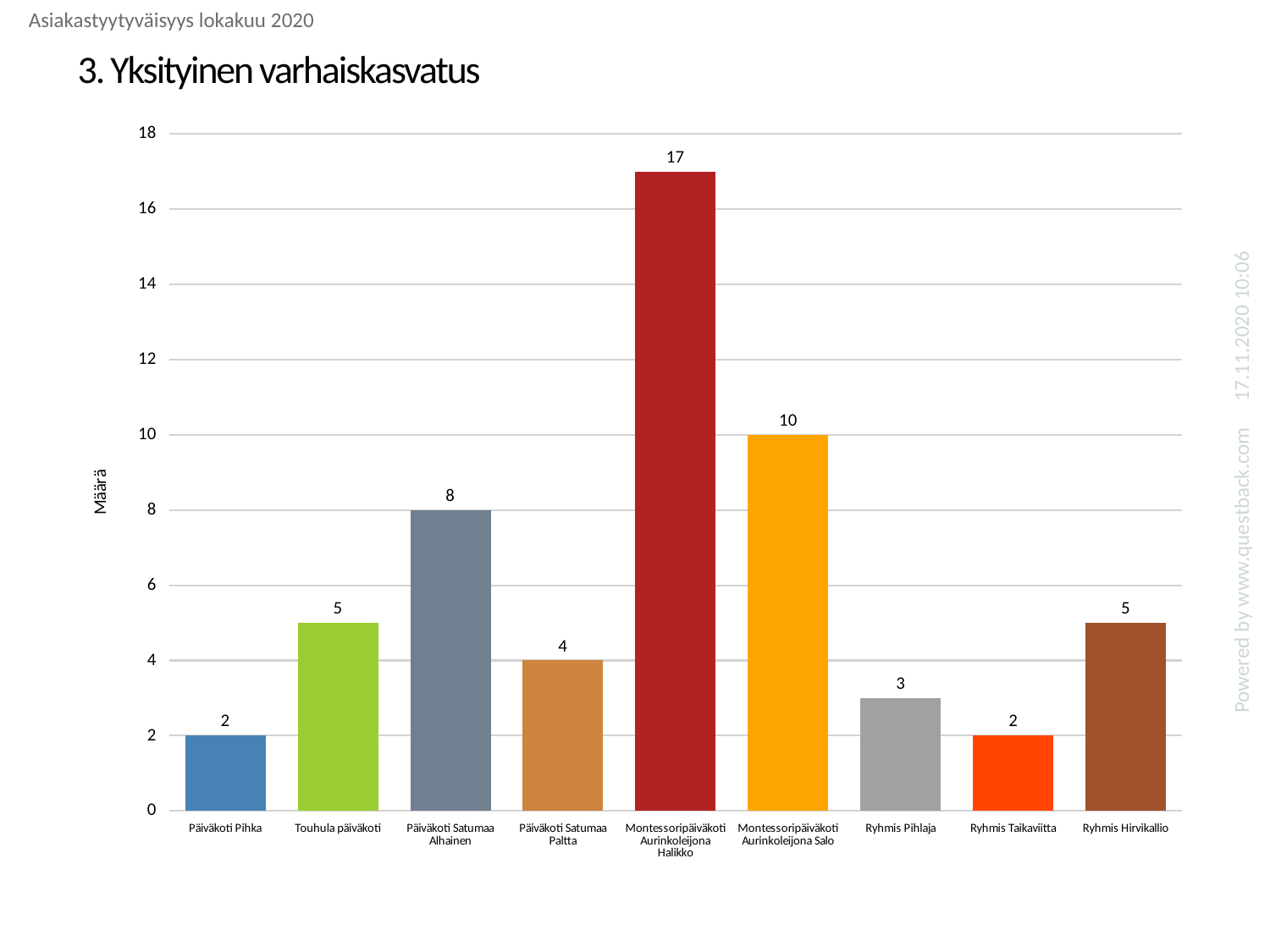
Is the value for Montessoripäiväkoti Aurinkoleijona Salo greater or less than 8? greater What is the difference between the values for Päiväkoti Satumaa Alhainen and Ryhmis Hirvikallio? 3 What is the value for Päiväkoti Satumaa Alhainen? 8 Which is larger, the value for Touhula päiväkoti or the value for Päiväkoti Satumaa Paltta? Touhula päiväkoti How many categories are shown on the x axis? 9 What is the value for Ryhmis Pihlaja? 3 What is the value for Montessoripäiväkoti Aurinkoleijona Halikko? 17 What kind of chart is shown on the slide? bar chart What is the label of the y axis? Määrä What is the difference between the values for Montessoripäiväkoti Aurinkoleijona Halikko and Montessoripäiväkoti Aurinkoleijona Salo? 7 What is the title of the chart? 3. Yksityinen varhaiskasvatus Which category has the highest value? Montessoripäiväkoti Aurinkoleijona Halikko